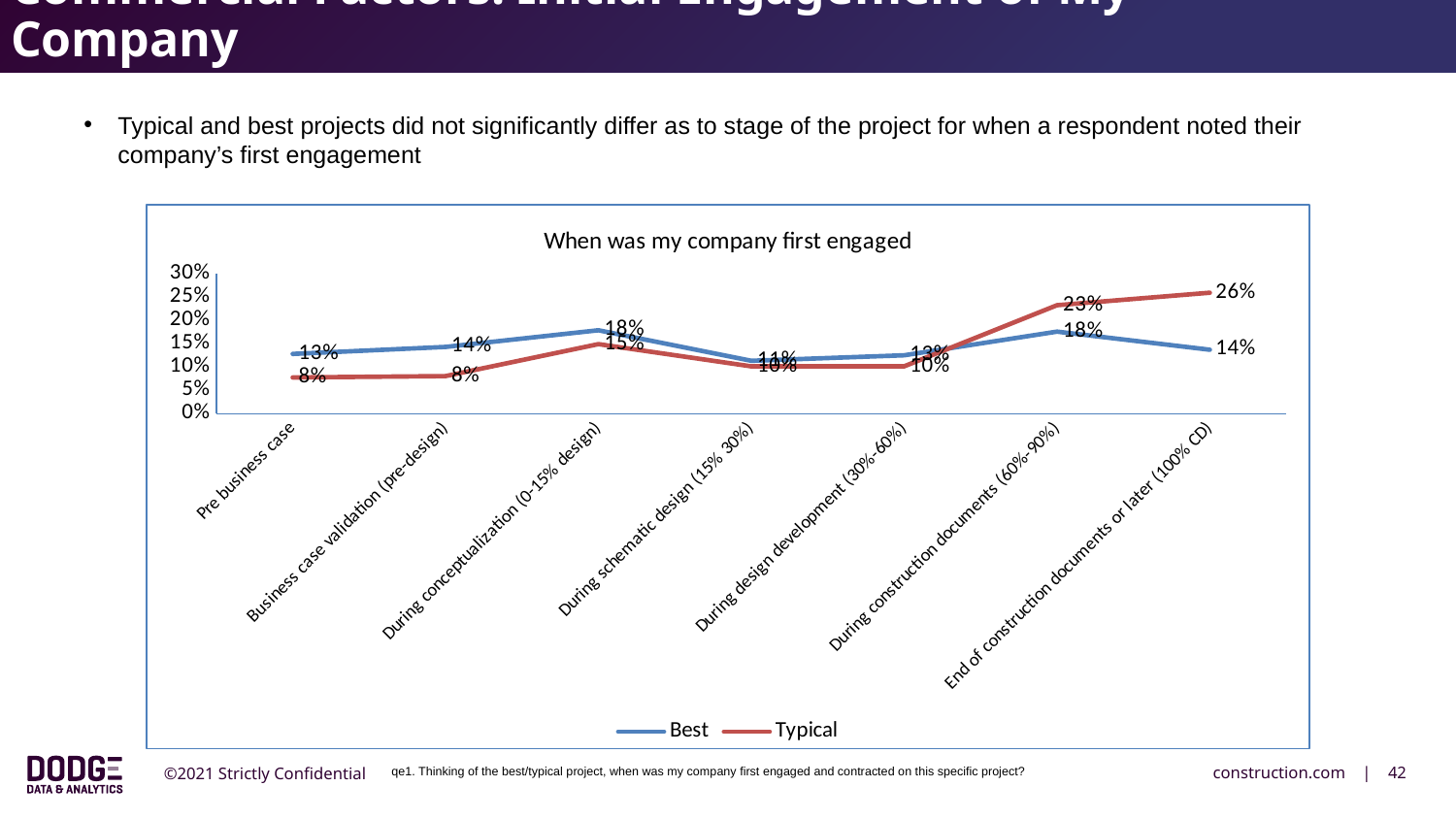
What is the difference between the Typical and Best values at 'End of construction documents or later (100% CD)'? 12 percentage points What is the title of the chart? When was my company first engaged What is the Typical value for 'End of construction documents or later (100% CD)'? 26% At 'During construction documents (60%-90%)', which series has the higher value, Best or Typical? Typical What is the Typical value for 'During construction documents (60%-90%)'? 23% How many series does the legend of the chart list? 2 What is the Best value for 'Pre business case'? 13% How many project stages are plotted along the x axis of the chart? 7 What kind of chart is shown on the slide? Line chart For which stage is the Typical series highest? End of construction documents or later (100% CD) What is the Best value for 'During conceptualization (0-15% design)'? 18% At 'Pre business case', which series has the higher value, Best or Typical? Best